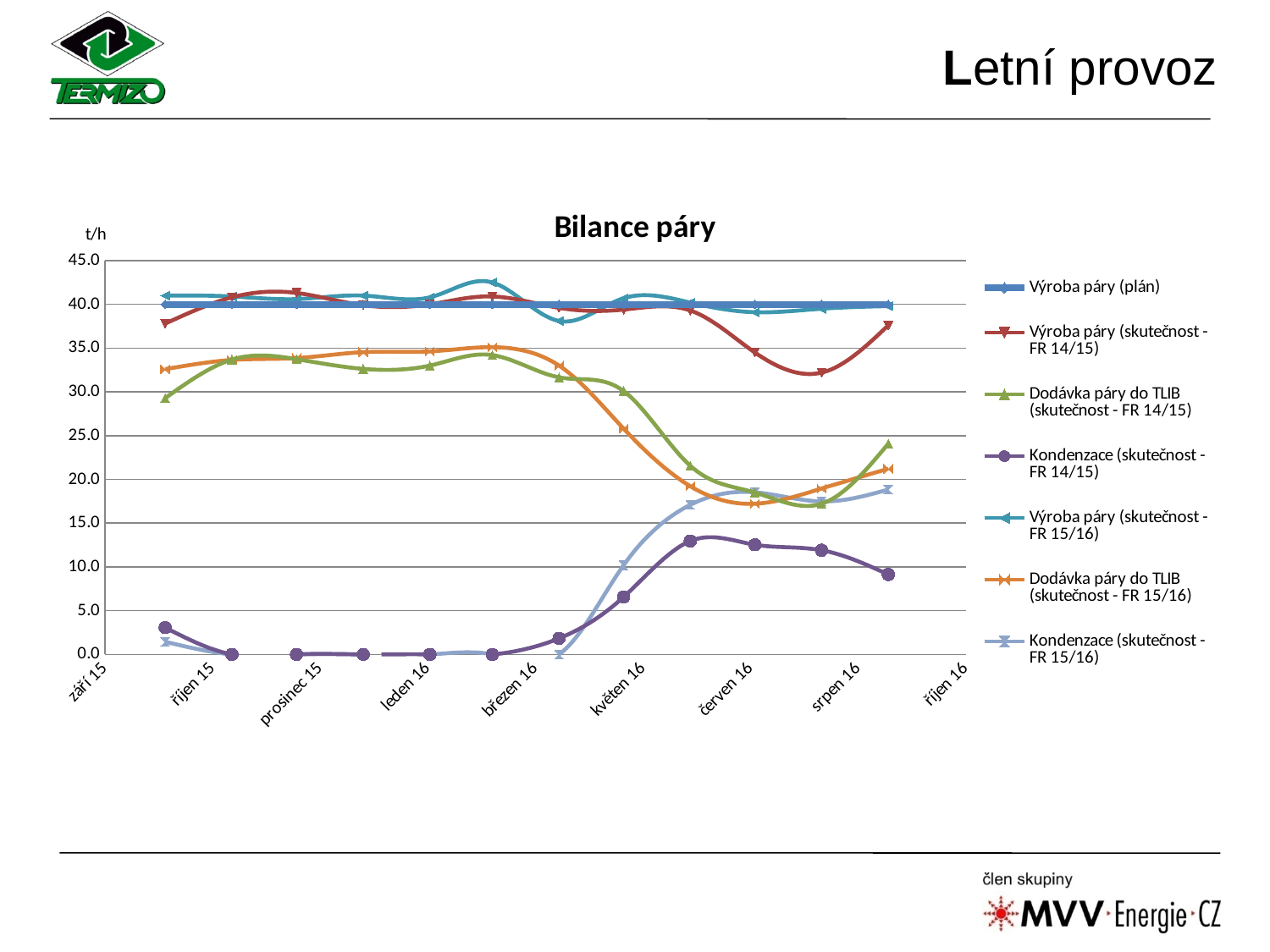
How many month labels are shown along the x axis of the chart? 9 Is the value for Dodávka páry do TLIB (skutečnost - FR 15/16) at leden 16 greater or less than 30.0? greater Is the value for Kondenzace (skutečnost - FR 14/15) at srpen 16 greater or less than 10.0? greater Is the value for Kondenzace (skutečnost - FR 15/16) at leden 16 greater or less than 5.0? less Does the Kondenzace (skutečnost - FR 14/15) line rise or fall between březen 16 and červen 16? rise What kind of chart is shown on the slide? line chart At what constant value does the Výroba páry (plán) line run across the chart? 40.0 What is the title of the chart? Bilance páry What unit is shown on the vertical axis of the chart? t/h How many series does the legend of the chart list? 7 Does the Dodávka páry do TLIB (skutečnost - FR 15/16) line rise or fall between březen 16 and červen 16? fall At srpen 16, which is larger: Kondenzace (skutečnost - FR 15/16) or Kondenzace (skutečnost - FR 14/15)? Kondenzace (skutečnost - FR 15/16)